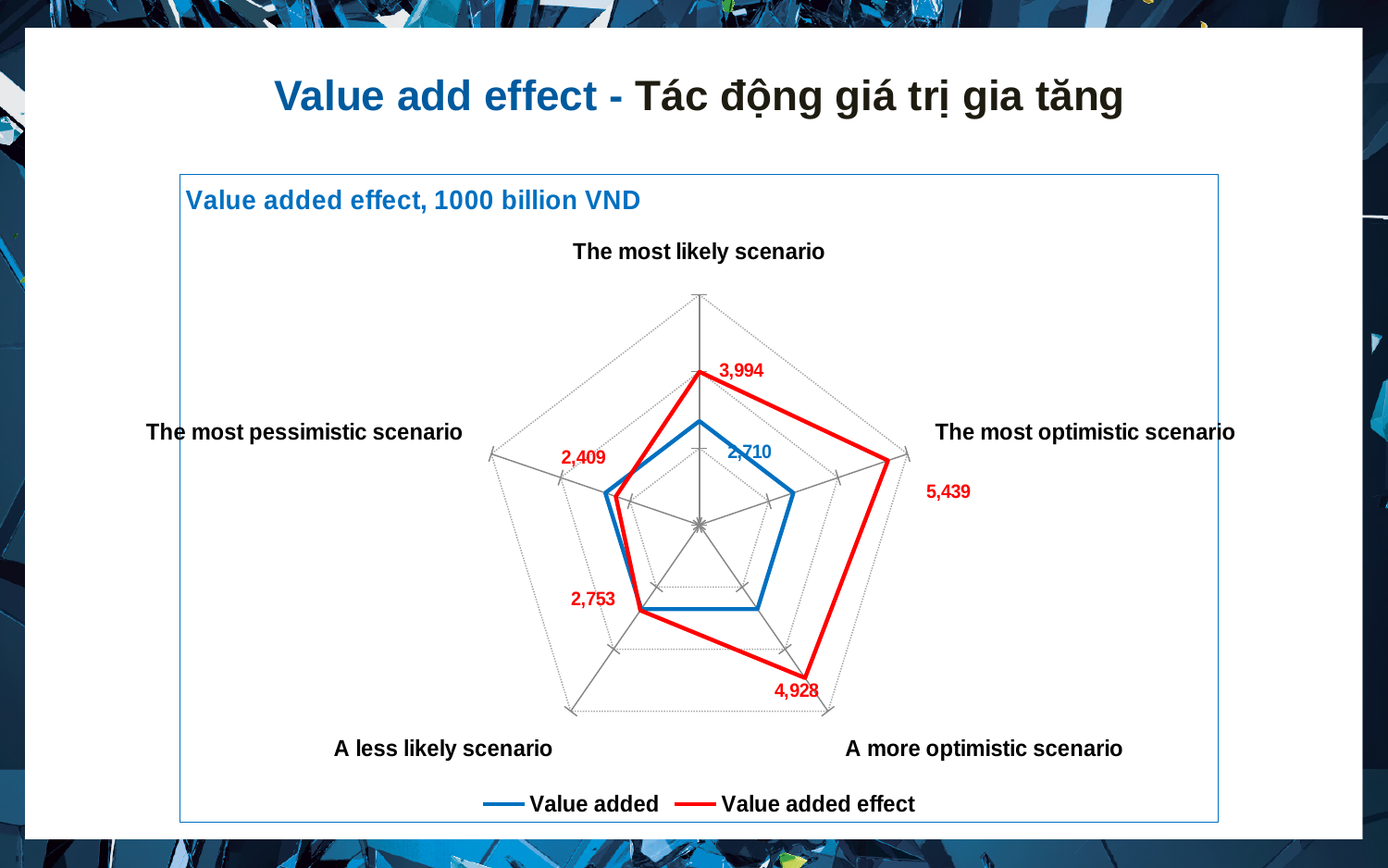
Which scenario has the lowest Value added effect? The most pessimistic scenario What is the Value added effect for The most pessimistic scenario? 2,409 What is the Value added effect for The most optimistic scenario? 5,439 Which scenario has the highest Value added effect? The most optimistic scenario What is the Value added effect for A more optimistic scenario? 4,928 How many series does the legend list? 2 What is the Value added for The most likely scenario? 2,710 What kind of chart is shown on the slide? Radar chart How many scenario categories are plotted on the radar chart? 5 What is the title of the chart? Value added effect, 1000 billion VND What is the difference between the Value added effect for The most optimistic scenario and A more optimistic scenario? 511 What is the Value added effect for The most likely scenario? 3,994